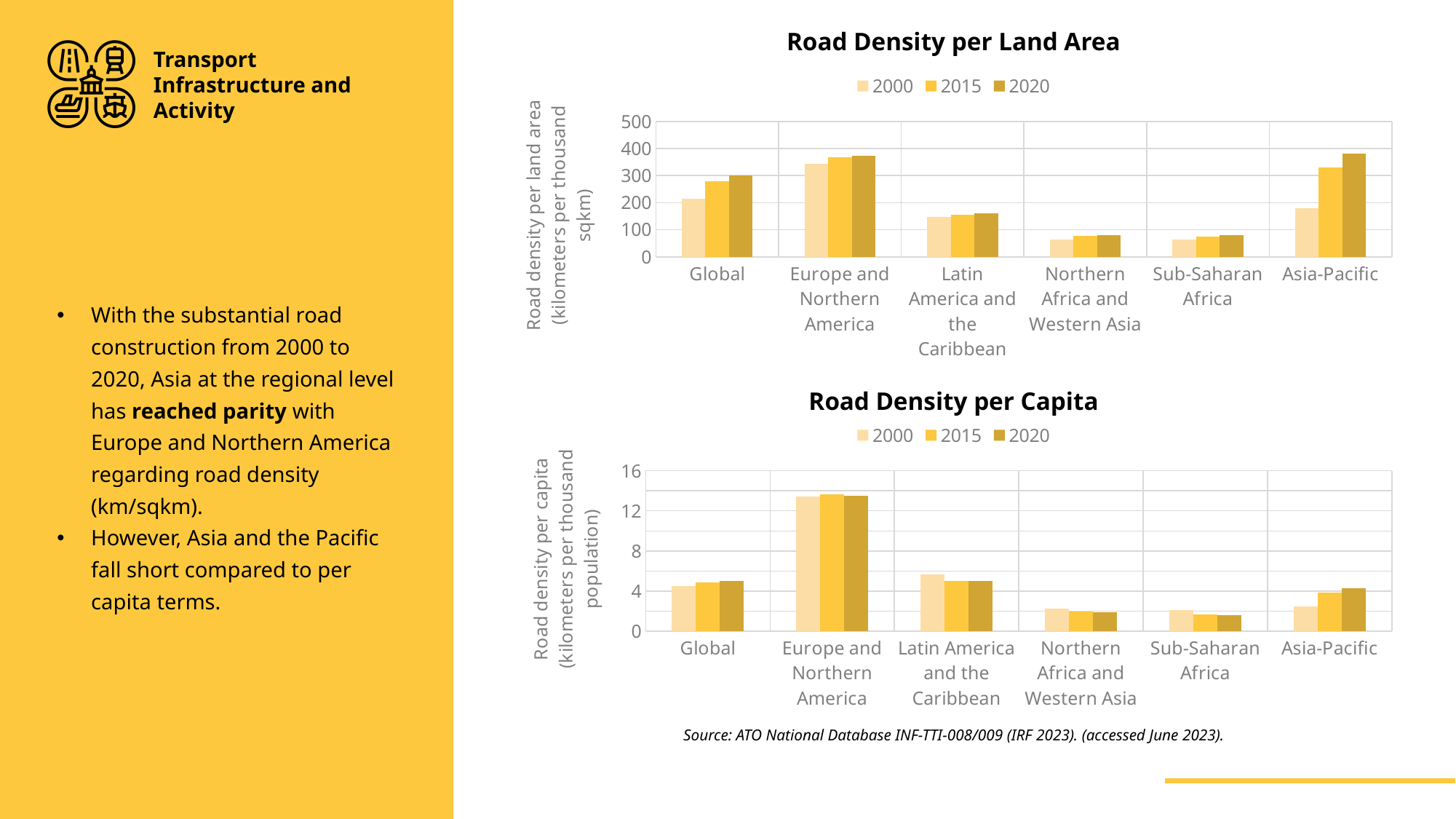
In the "Road Density per Capita" chart, which is larger for 2000: Global or Latin America and the Caribbean? Latin America and the Caribbean In the "Road Density per Capita" chart, do the values for Sub-Saharan Africa rise or fall from 2000 to 2020? fall What is the y-axis label of the "Road Density per Capita" chart? Road density per capita (kilometers per thousand population) How many regional categories are shown on the x axis of the "Road Density per Capita" chart? 6 What kind of chart is the "Road Density per Land Area" chart? bar chart In the "Road Density per Land Area" chart, which region has the highest value for 2000? Europe and Northern America In the "Road Density per Land Area" chart, is the 2020 value for Asia-Pacific greater or less than 300? greater In the "Road Density per Capita" chart, is the 2020 value for Europe and Northern America greater or less than 12? greater In the "Road Density per Land Area" chart, is the 2000 value for Northern Africa and Western Asia greater or less than 100? less How many series does the legend of the "Road Density per Land Area" chart list? 3 In the "Road Density per Land Area" chart, do the values for Asia-Pacific rise or fall from 2000 to 2020? rise In the "Road Density per Capita" chart, which region has the highest value for 2020? Europe and Northern America